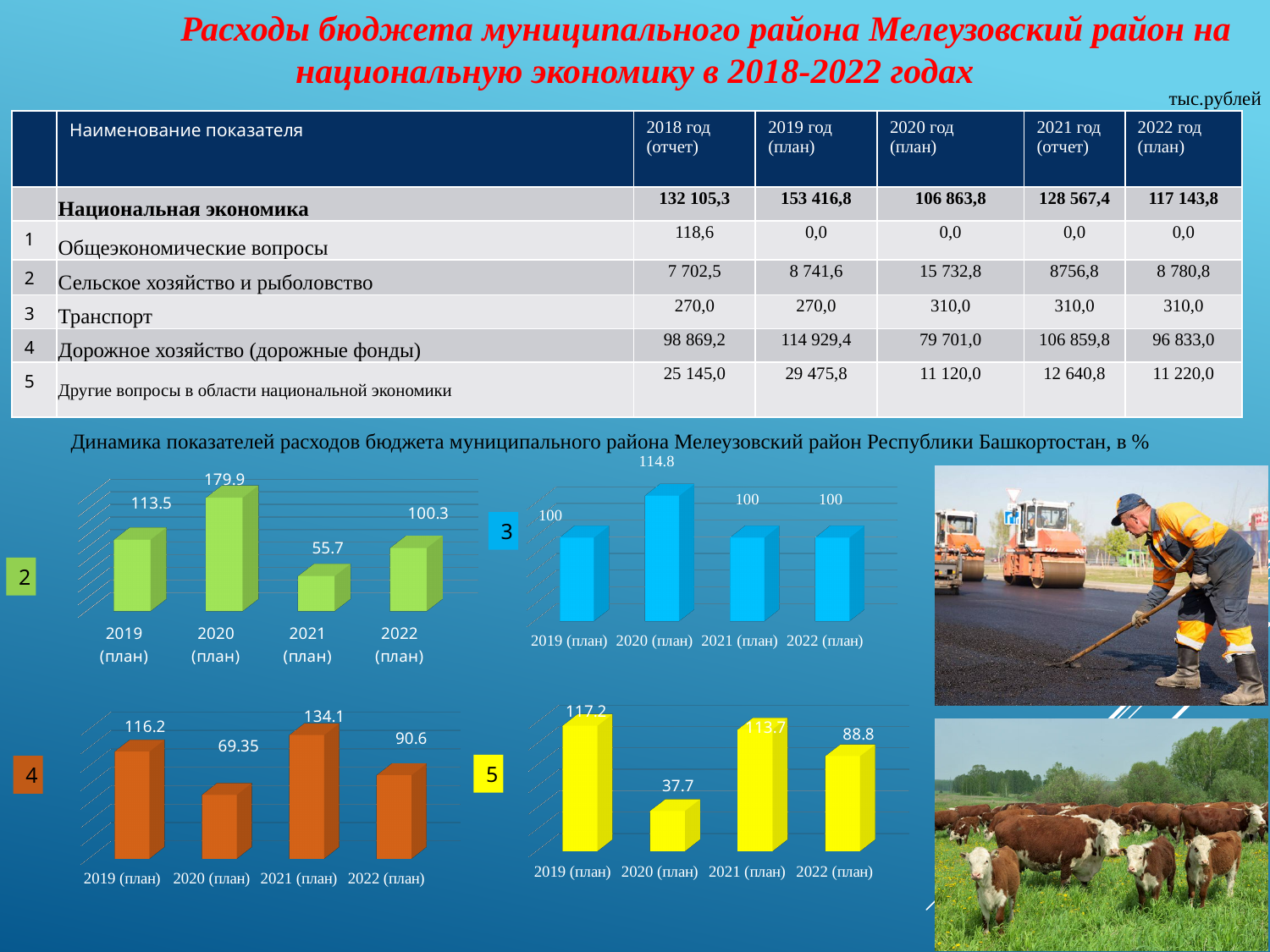
In the yellow bar chart labelled 5 (bottom middle), what is the value for 2021 (план)? 113.7 In the green bar chart labelled 2 (top left), what is the difference between the 2020 (план) and 2021 (план) values? 124.2 In the blue bar chart labelled 3 (top middle), which year has the highest value? 2020 (план) In the green bar chart labelled 2 (top left), what is the value for 2020 (план)? 179.9 In the blue bar chart labelled 3 (top middle), what is the value for 2020 (план)? 114.8 In the yellow bar chart labelled 5 (bottom middle), what is the difference between the 2019 (план) and 2020 (план) values? 79.5 In the blue bar chart labelled 3 (top middle), how many bars are plotted? 4 In the green bar chart labelled 2 (top left), which year has the lowest value? 2021 (план) What type of chart is the yellow chart labelled 5 (bottom middle)? Bar chart In the orange bar chart labelled 4 (bottom left), what is the value for 2020 (план)? 69.35 In the orange bar chart labelled 4 (bottom left), which is larger, the value for 2019 (план) or 2022 (план)? 2019 (план) In the orange bar chart labelled 4 (bottom left), which year has the highest value? 2021 (план)